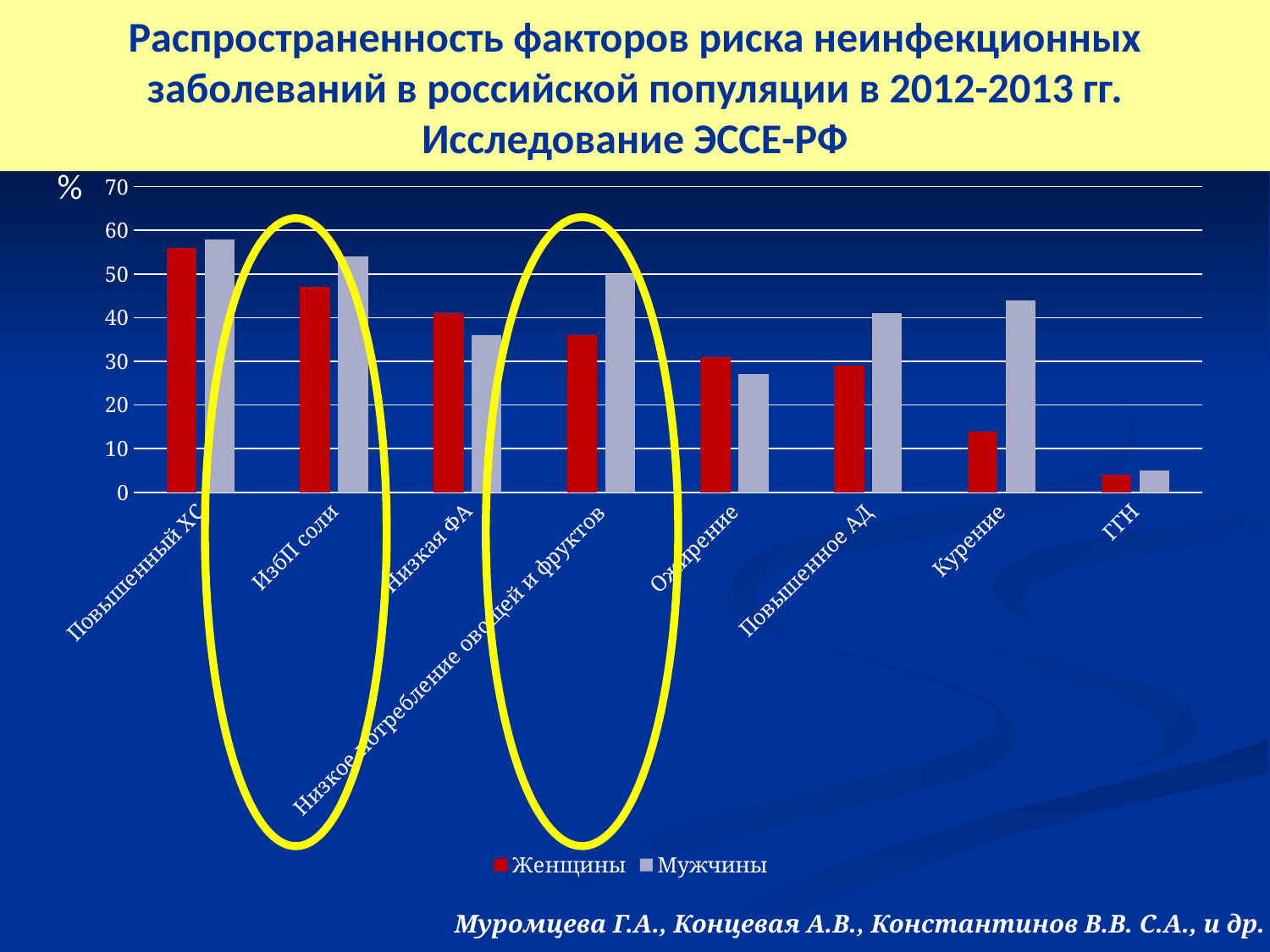
Which colour represents the Женщины series in the chart? red What kind of chart is shown on the slide? bar chart Is the value for Мужчины in Курение greater or less than 40? greater How many series does the legend list? 2 Is the value for Женщины in Курение greater or less than 20? less How many risk-factor categories are shown on the x axis? 8 Which category has the highest value for Женщины? Повышенный ХС Which category has the lowest value for Женщины? ГГН Is the value for Мужчины in Низкое потребление овощей и фруктов greater or less than 40? greater For Низкая ФА, which series has the larger value, Женщины or Мужчины? Женщины For Курение, which series has the larger value, Женщины or Мужчины? Мужчины Which category has the lowest value for Мужчины? ГГН